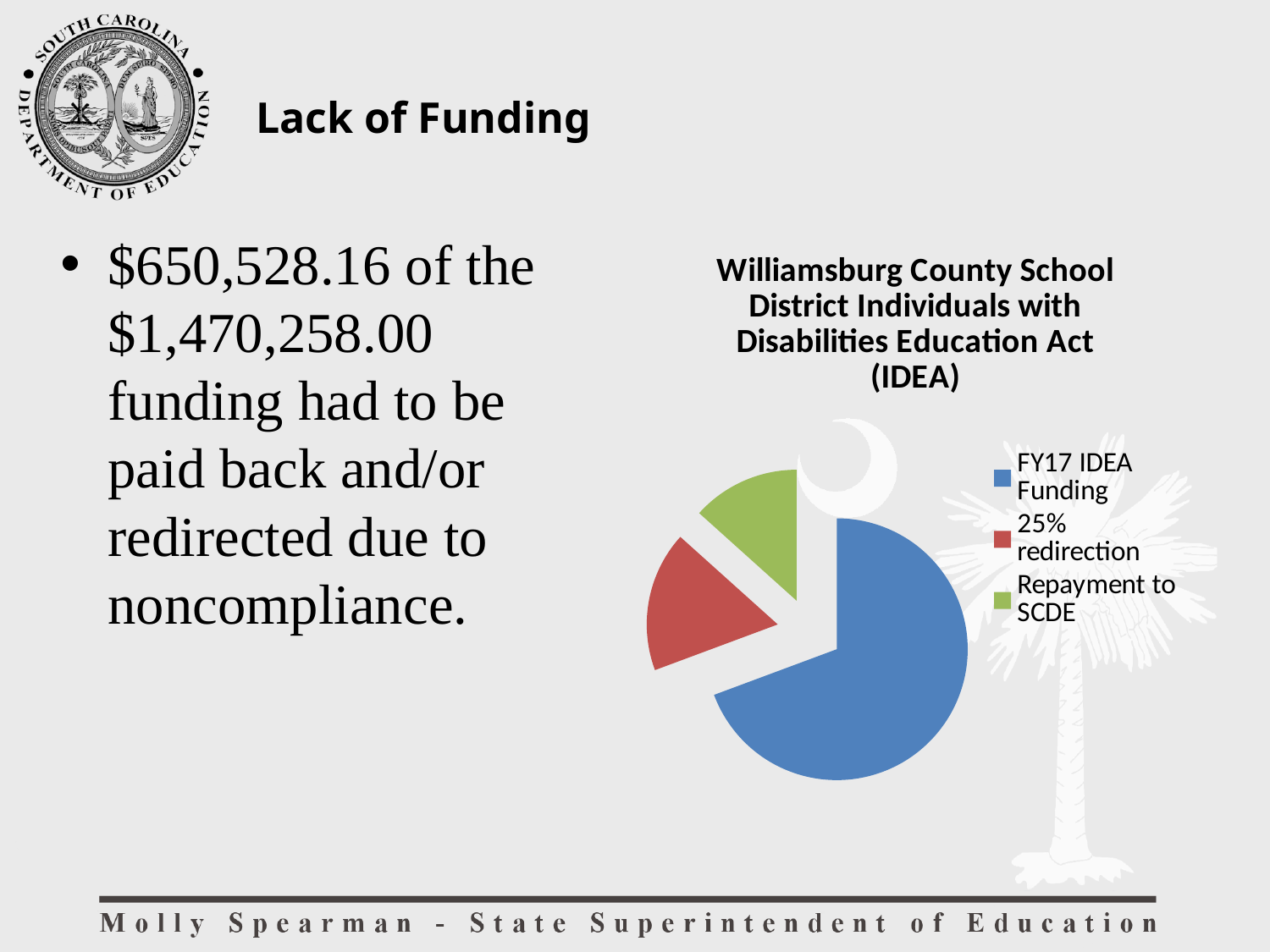
How many slices does the pie chart have? 3 Which is larger in the pie chart, the FY17 IDEA Funding slice or the 25% redirection slice? FY17 IDEA Funding Which is larger in the pie chart, the Repayment to SCDE slice or the FY17 IDEA Funding slice? FY17 IDEA Funding What colour is the FY17 IDEA Funding slice in the pie chart? blue What kind of chart is shown on the slide? pie chart What is the title of the pie chart? Williamsburg County School District Individuals with Disabilities Education Act (IDEA) Which slice of the pie chart is the largest? FY17 IDEA Funding How many entries does the legend of the pie chart list? 3